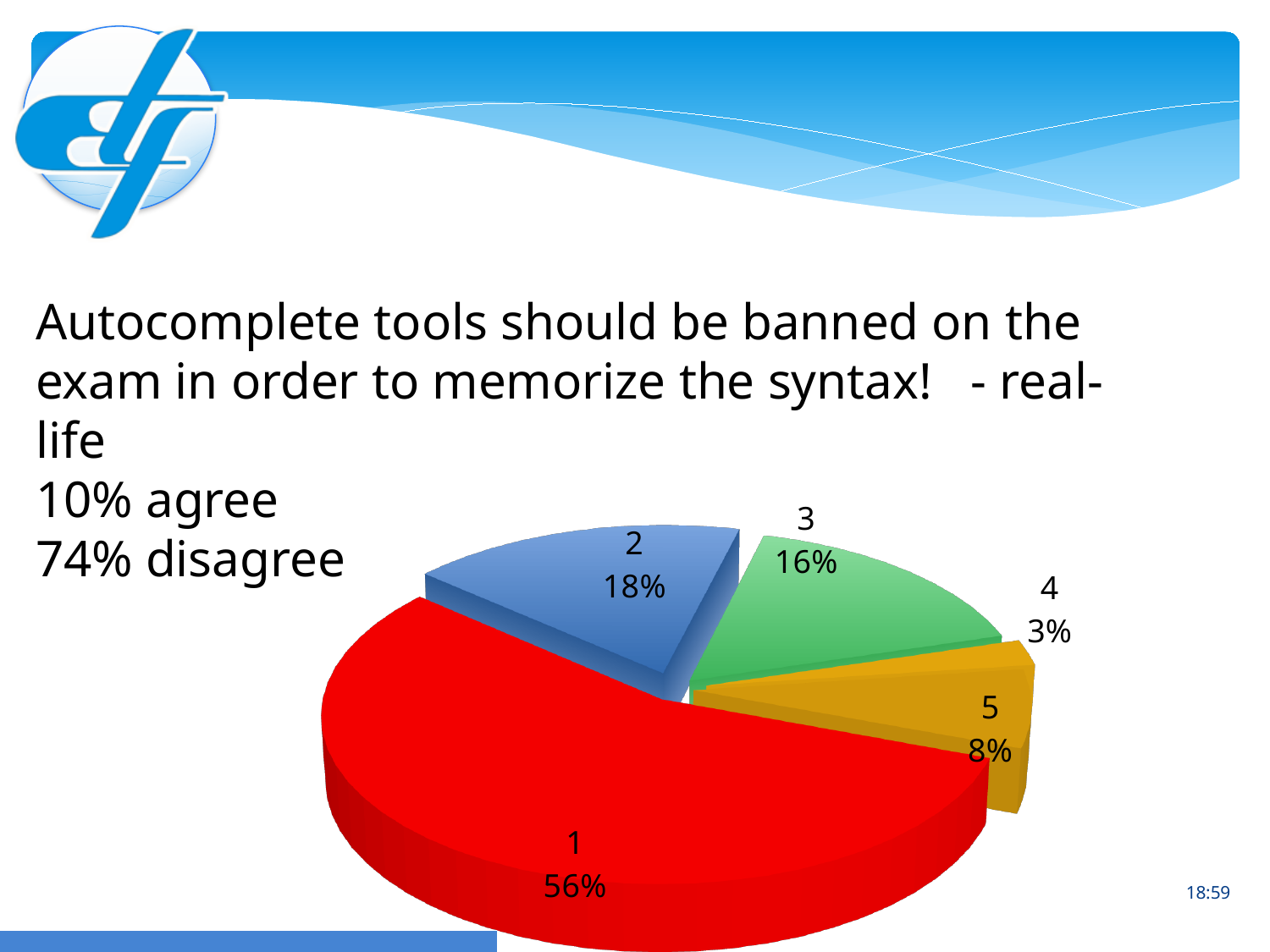
Which slice is larger, slice 3 or slice 5? 3 Which slice of the pie chart is the largest? 1 What is the difference in percentage points between slice 1 and slice 2? 38 What share of the pie does slice 2 represent? 18% Which slice of the pie chart is the smallest? 4 What colour is the largest slice of the pie chart? red What share of the pie does slice 1 represent? 56% What share of the pie does slice 5 represent? 8% How many slices does the pie chart have? 5 What kind of chart is shown on the slide? pie chart